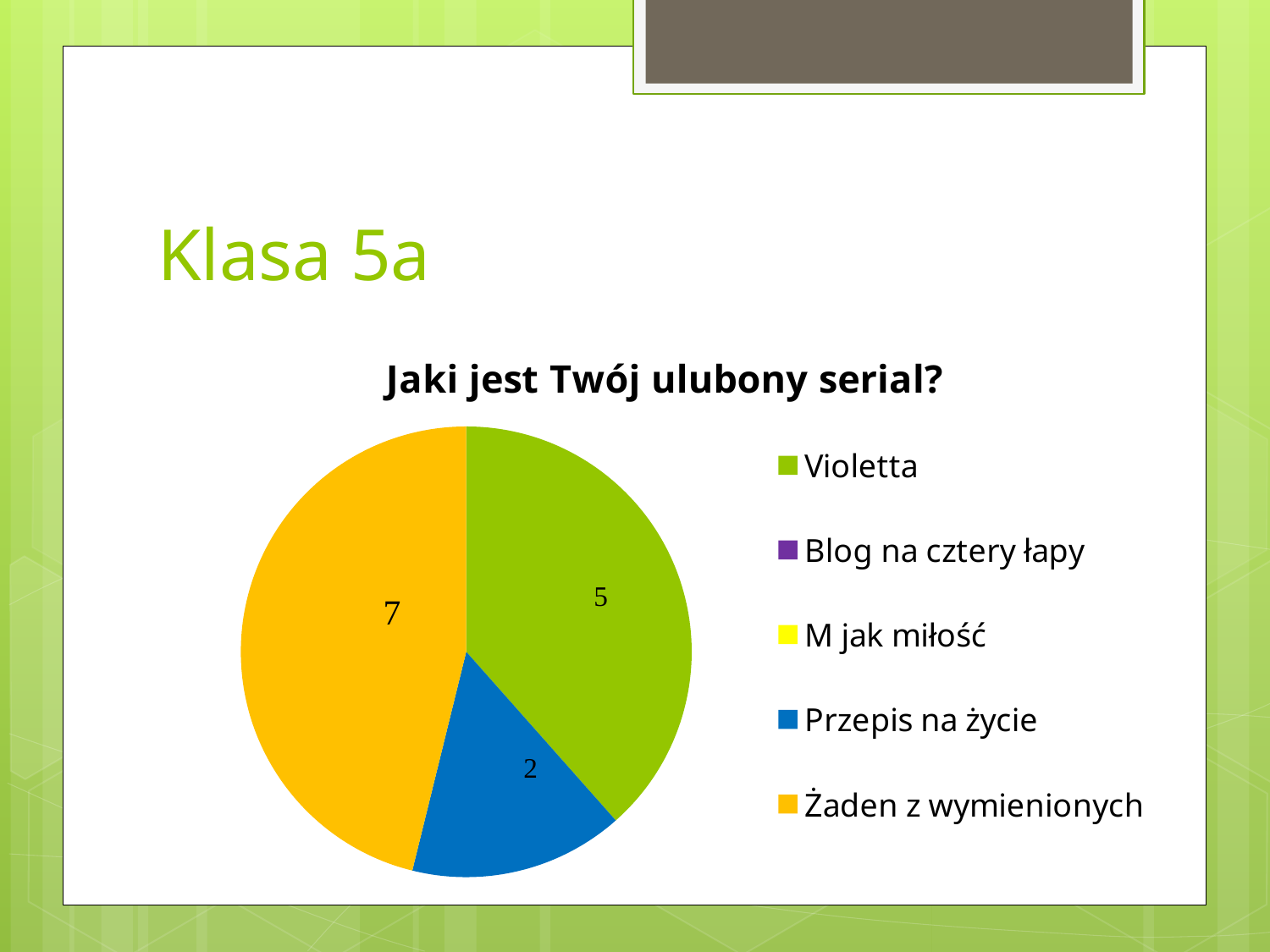
What type of chart is shown on the slide? pie chart How many entries does the legend list? 5 What is the difference between the values for Żaden z wymienionych and Violetta? 2 Which of the slices shown in the pie is the smallest? Przepis na życie What is the title of the chart? Jaki jest Twój ulubony serial? Which category has the largest slice of the pie? Żaden z wymienionych What is the value for Żaden z wymienionych? 7 What is the value for Przepis na życie? 2 Which is larger, the value for Violetta or the value for Przepis na życie? Violetta What is the value for Violetta? 5 What is the difference between the values for Violetta and Przepis na życie? 3